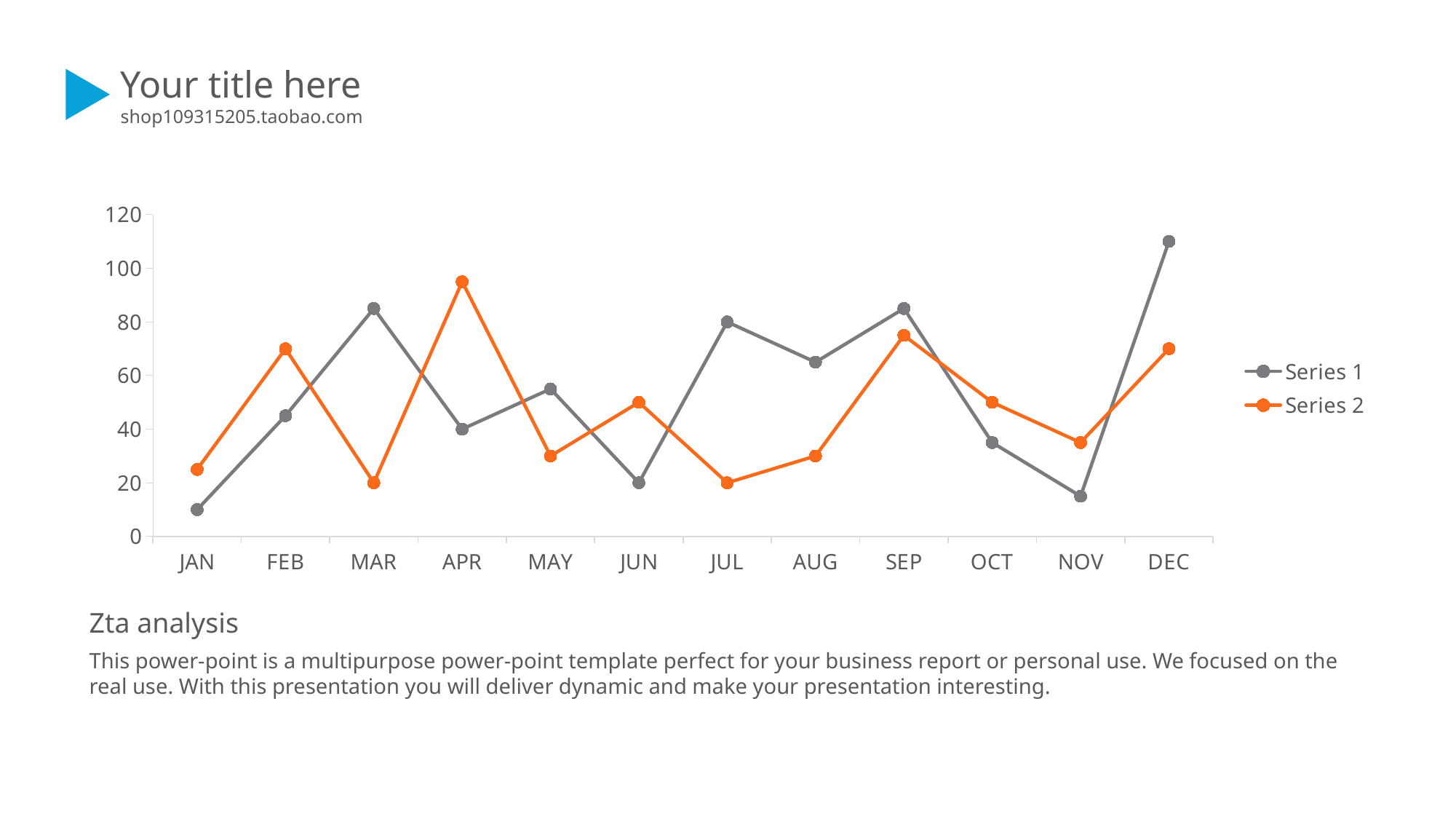
What kind of chart is shown on the slide? line chart In MAR, which series has the larger value, Series 1 or Series 2? Series 1 Does Series 1 rise or fall from SEP to NOV? fall In which month does Series 1 reach its highest value? DEC How many series does the legend list? 2 Is the value of Series 1 in DEC greater or less than 100? greater In which month does Series 2 reach its highest value? APR How many months are shown on the x axis? 12 Is the value of Series 2 in NOV greater or less than 40? less What colour is the line for Series 2? orange What is the value of Series 1 in JUL? 80 What is the value of Series 1 in JUN? 20